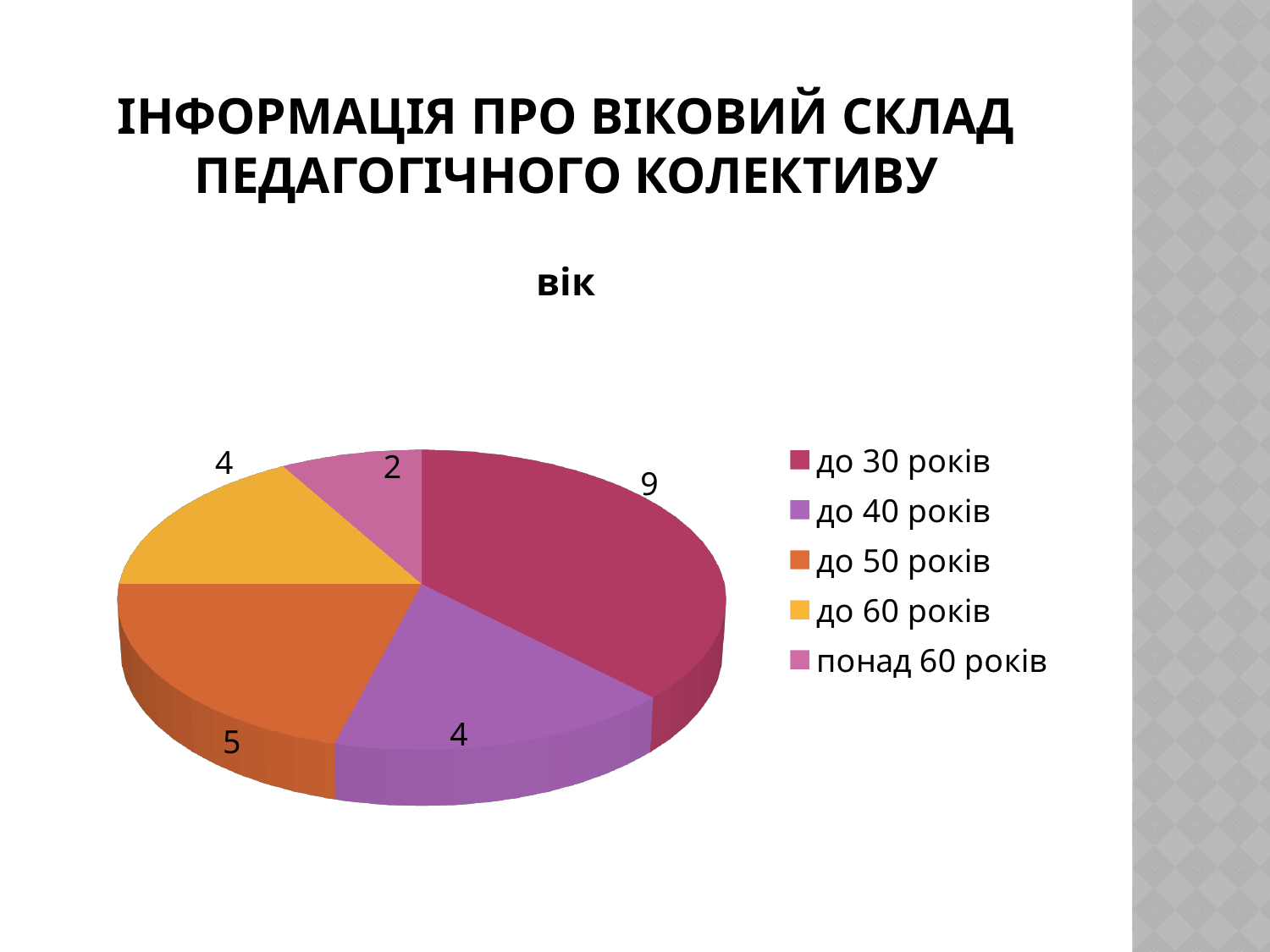
How many slices does the pie chart have? 5 What is the difference between the values for до 30 років and до 50 років? 4 What share of the pie does до 30 років represent? 37.5% Which is larger, the value for до 50 років or the value for понад 60 років? до 50 років What is the title of the chart? вік What is the value for до 50 років? 5 What is the value for до 30 років? 9 Which category has the smallest slice? понад 60 років What kind of chart is shown on the slide? pie chart What is the value for понад 60 років? 2 Which category has the largest slice? до 30 років What is the total of all the slice values in the pie chart? 24